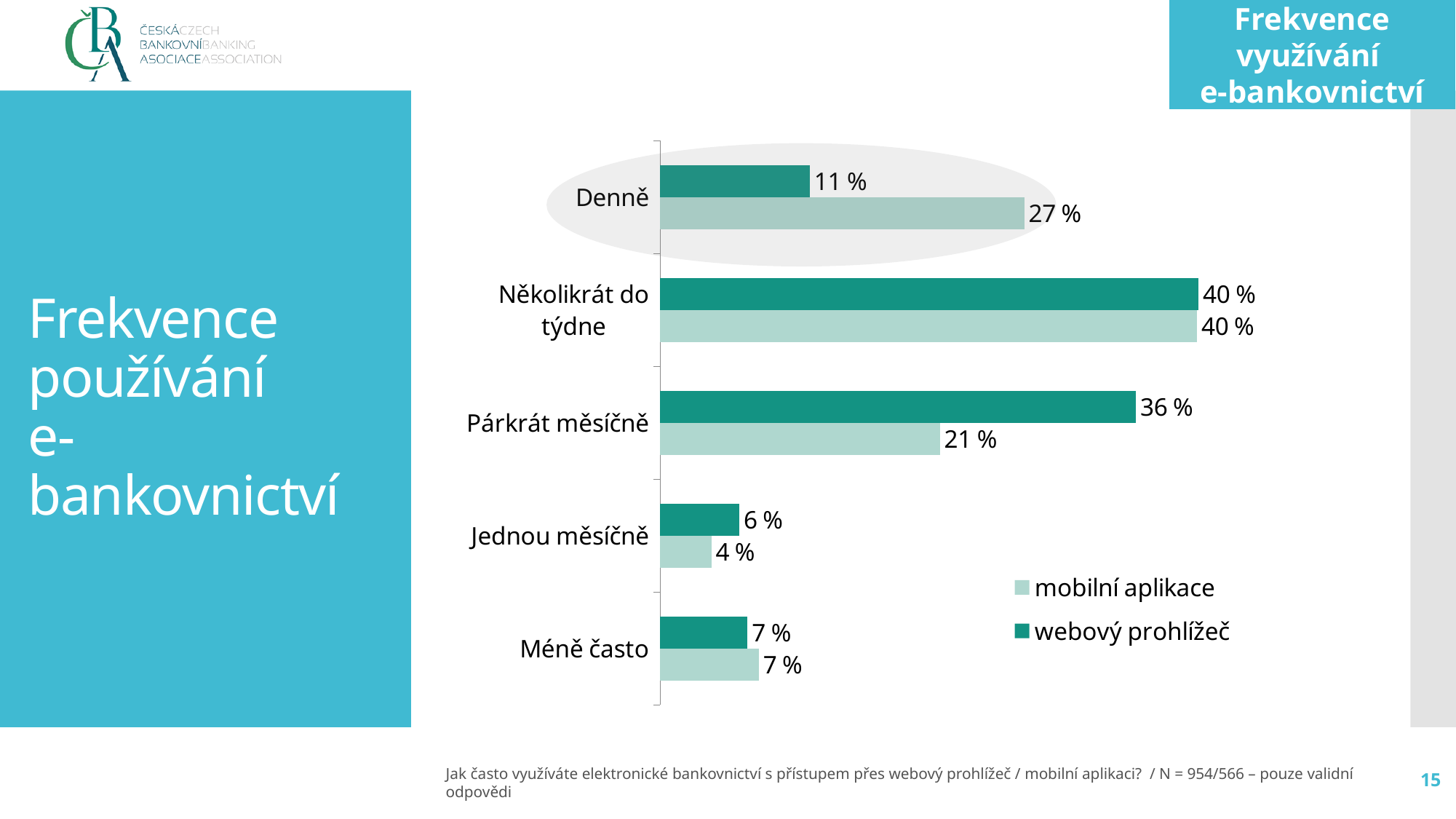
In the 'Denně' category, which series has the larger value, 'mobilní aplikace' or 'webový prohlížeč'? mobilní aplikace Which category has the lowest value for 'mobilní aplikace'? Jednou měsíčně What is the difference between 'webový prohlížeč' and 'mobilní aplikace' in the 'Párkrát měsíčně' category? 15 % How many categories are shown on the chart? 5 What is the value for 'webový prohlížeč' in the 'Jednou měsíčně' category? 6 % Which category on the chart is highlighted with a grey ellipse? Denně What is the value for 'mobilní aplikace' in the 'Párkrát měsíčně' category? 21 % What is the value for 'mobilní aplikace' in the 'Denně' category? 27 % What is the value for 'webový prohlížeč' in the 'Denně' category? 11 % Which category has the highest value for 'webový prohlížeč'? Několikrát do týdne What kind of chart is shown on the slide? bar chart How many series does the legend list? 2